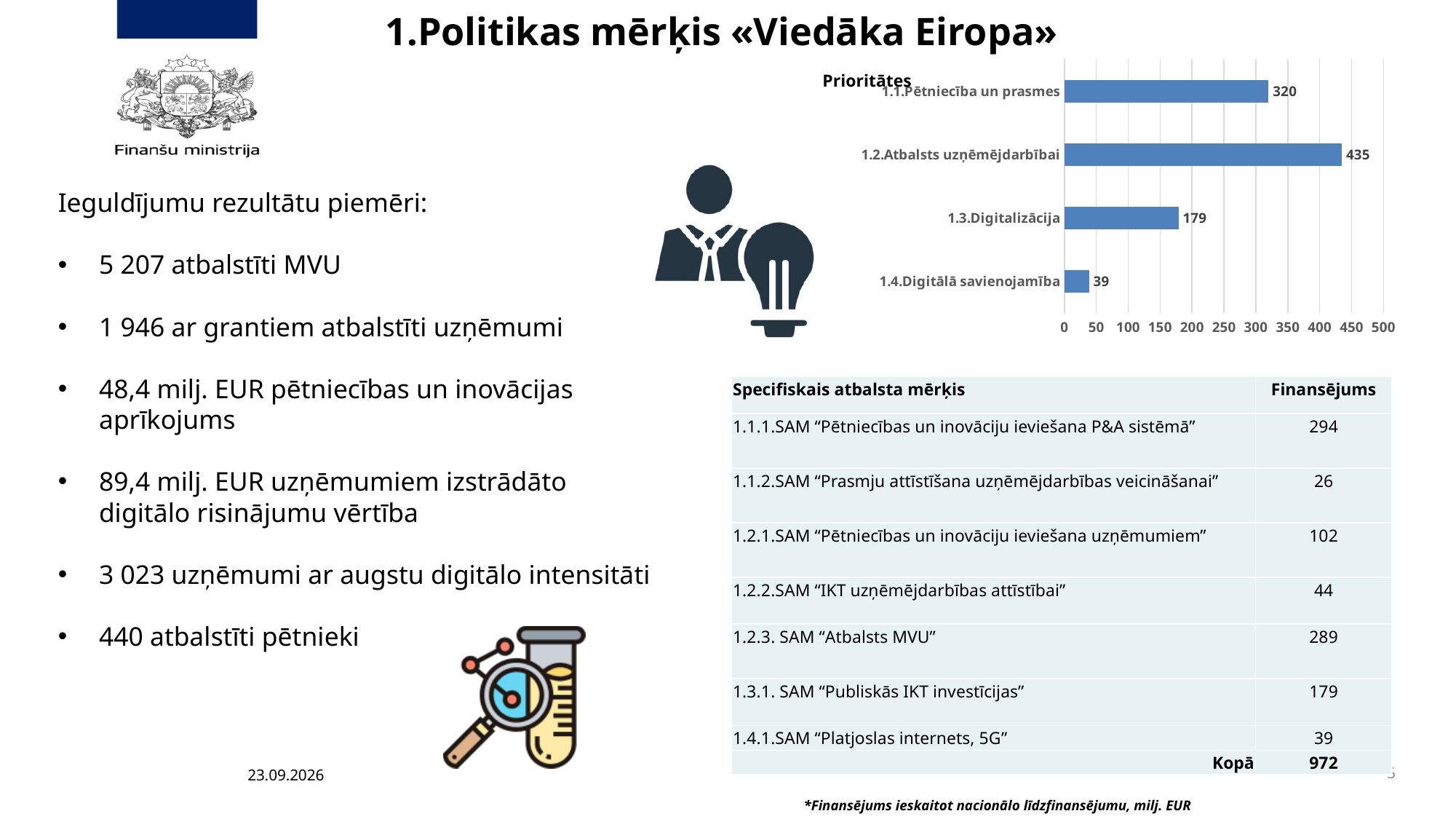
What is the value for 1.4.Digitālā savienojamība in the bar chart? 39 Which is larger in the bar chart: 1.3.Digitalizācija or 1.1.Pētniecība un prasmes? 1.1.Pētniecība un prasmes What is the difference between the values for 1.2.Atbalsts uzņēmējdarbībai and 1.1.Pētniecība un prasmes? 115 What is the value for 1.1.Pētniecība un prasmes in the bar chart? 320 What is the value for 1.2.Atbalsts uzņēmējdarbībai in the bar chart? 435 What is the title of the chart on the slide? Prioritātes What is the value for 1.3.Digitalizācija in the bar chart? 179 Is the value for 1.2.Atbalsts uzņēmējdarbībai greater or less than 400? greater Which category has the lowest value in the bar chart? 1.4.Digitālā savienojamība What type of chart is shown on the slide? bar chart How many categories are shown in the bar chart? 4 Which category has the highest value in the bar chart? 1.2.Atbalsts uzņēmējdarbībai